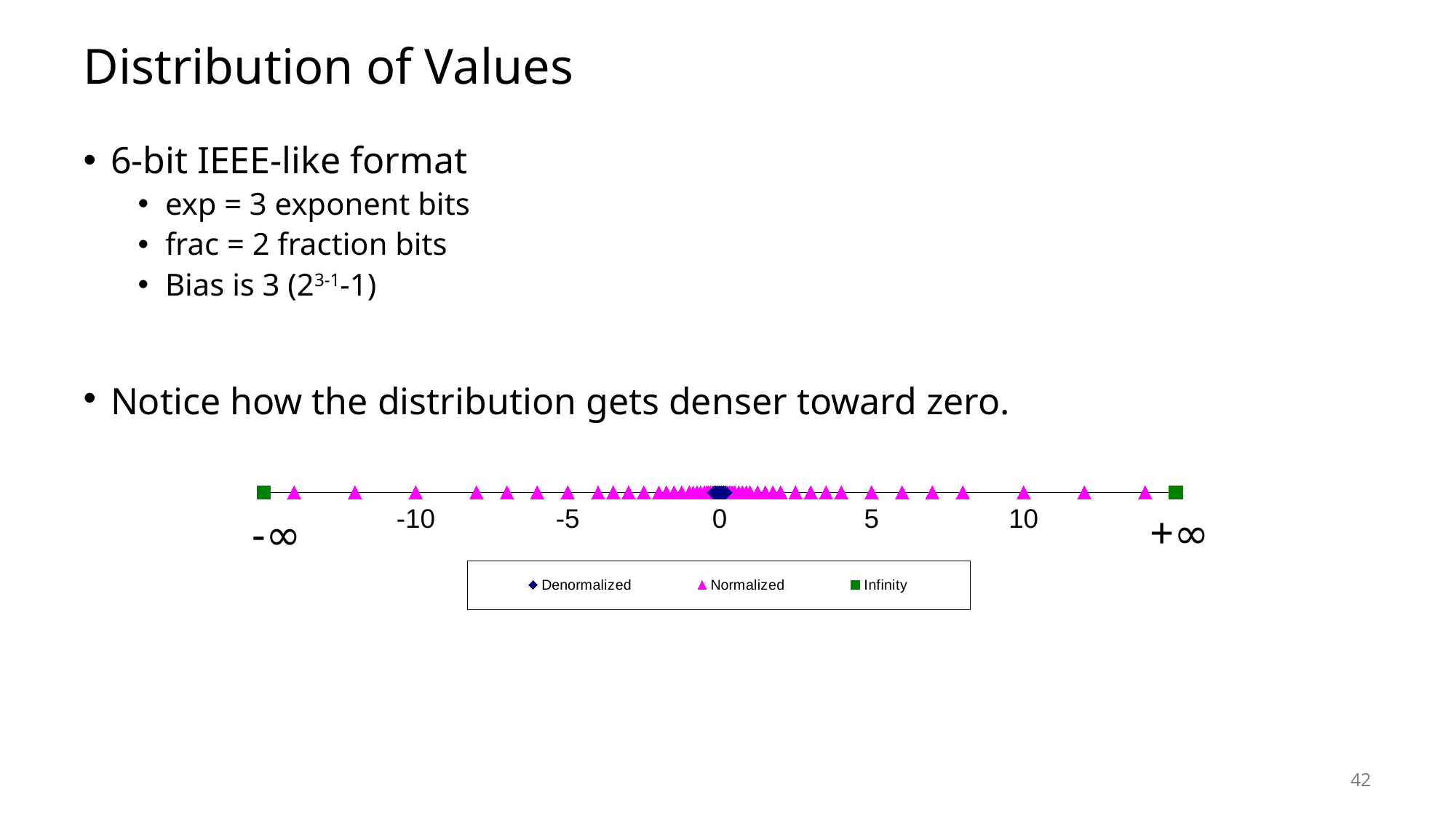
How many Infinity markers (green squares) are plotted on the chart? 2 Which series has more plotted points on the chart, Normalized or Infinity? Normalized Which series in the chart is plotted with magenta triangles? Normalized Around which axis value are the Denormalized points clustered? 0 What is the smallest numeric tick label shown on the chart's axis? -10 How many series does the legend of the chart list? 3 How many numeric tick labels (excluding the infinity labels) are shown on the axis? 5 What are the three series named in the chart's legend? Denormalized, Normalized, Infinity What is the largest numeric tick label shown on the chart's axis? 10 Does the spacing between Normalized points get denser or sparser as values move toward zero? Denser What kind of chart is shown on the slide? Scatter chart (number line) Which series is plotted at the two extreme ends of the number line, labelled -∞ and +∞? Infinity